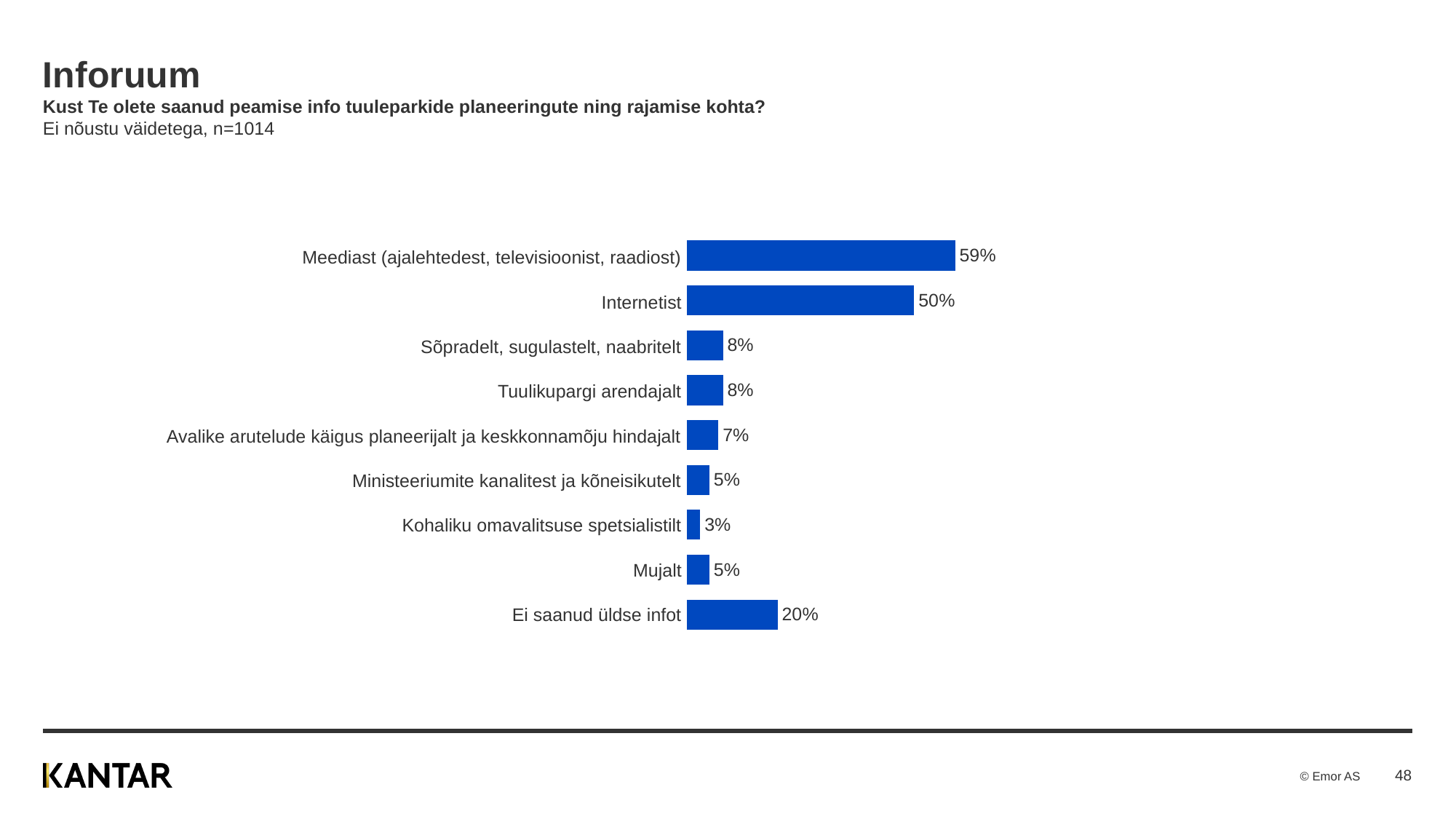
What is the sample size (n) stated in the chart subtitle? n=1014 What is the value for Internetist? 50% Which category has the lowest value? Kohaliku omavalitsuse spetsialistilt What is the difference between the values for Meediast (ajalehtedest, televisioonist, raadiost) and Internetist? 9% What kind of chart is shown on the slide? Bar chart What is the value for Kohaliku omavalitsuse spetsialistilt? 3% What is the value for Ei saanud üldse infot? 20% How many categories are shown in the chart? 9 Which is larger, the value for Ei saanud üldse infot or the value for Sõpradelt, sugulastelt, naabritelt? Ei saanud üldse infot Which category has the highest value? Meediast (ajalehtedest, televisioonist, raadiost) What is the difference between the values for Avalike arutelude käigus planeerijalt ja keskkonnamõju hindajalt and Ministeeriumite kanalitest ja kõneisikutelt? 2% What is the value for Meediast (ajalehtedest, televisioonist, raadiost)? 59%